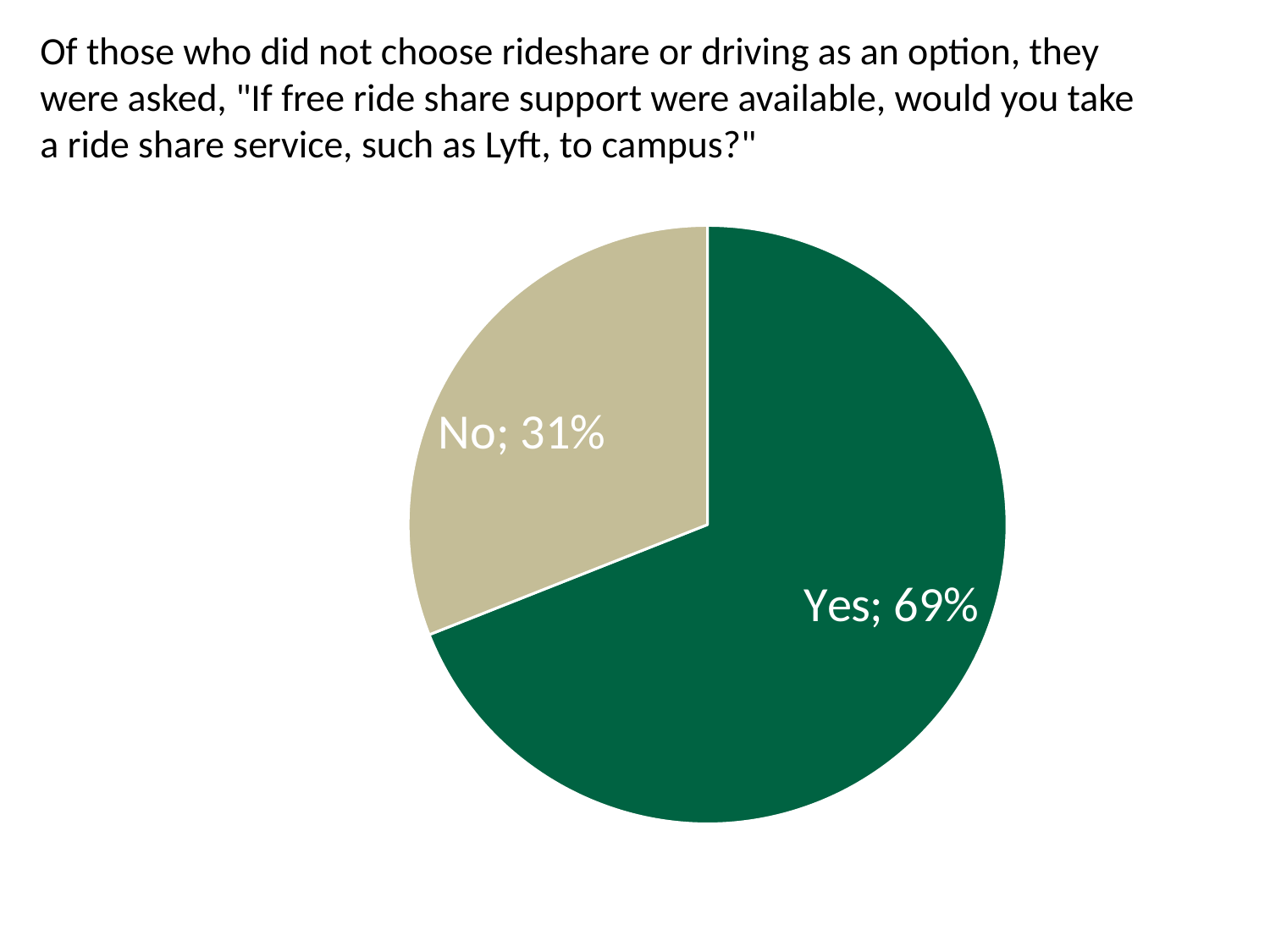
What percentage of respondents answered No? 31% What colour is the Yes slice of the pie? dark green What kind of chart is shown on the slide? pie chart What is the difference in percentage points between the Yes and No responses? 38 What colour is the No slice of the pie? tan Which response has the largest share of the pie? Yes How many slices does the pie chart have? 2 What percentage of respondents answered Yes? 69% Which response has the smallest share of the pie? No Is the share for Yes greater or less than 50%? greater Which is larger, the Yes share or the No share? Yes